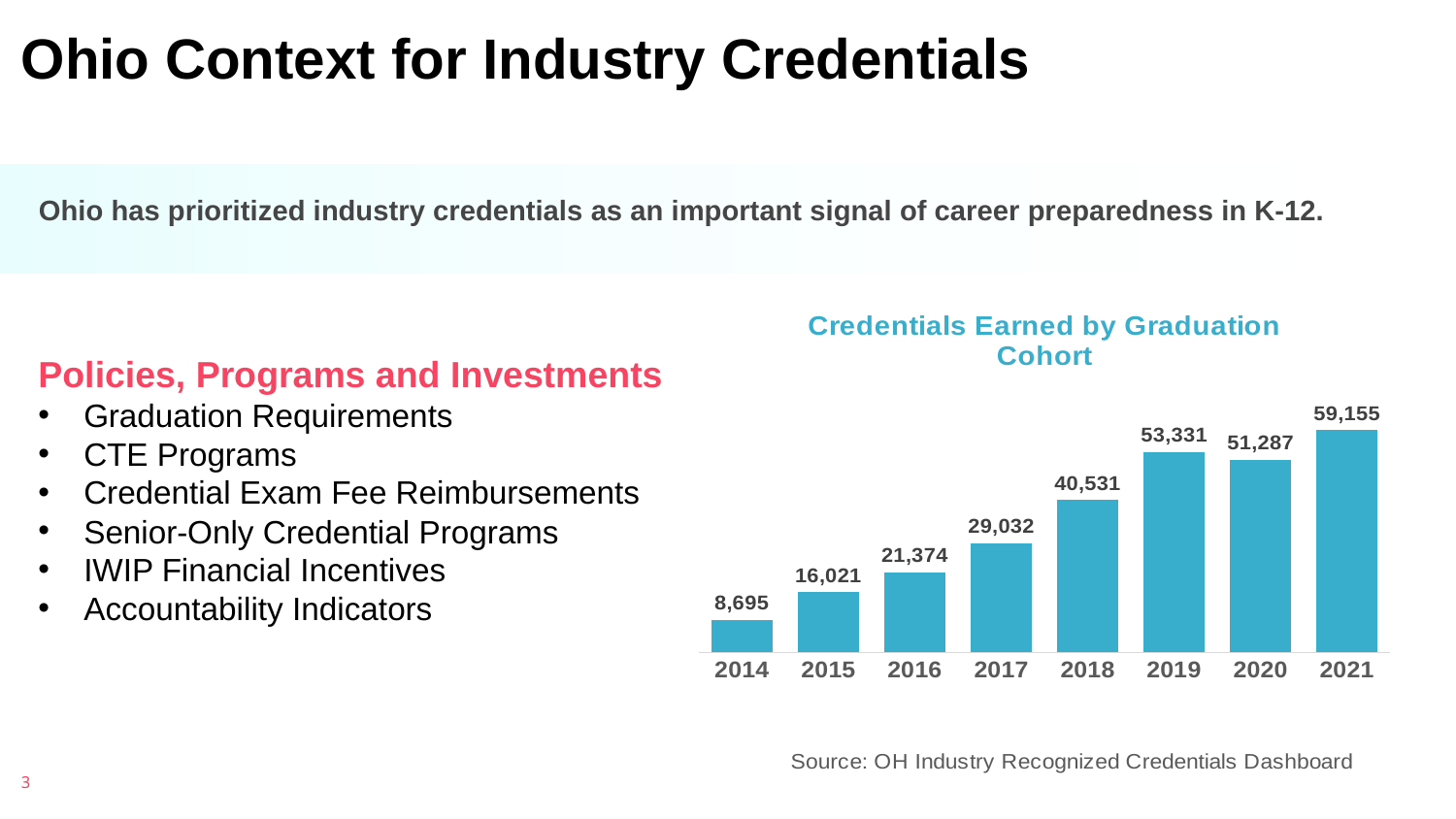
What is the difference between the 2021 and 2020 values? 7,868 What type of chart is used to show credentials earned by graduation cohort? Bar chart Which year has the highest number of credentials earned? 2021 How many graduation cohorts (years) are shown in the chart? 8 What is the value for 2014 in the Credentials Earned by Graduation Cohort chart? 8,695 Which is larger, the value for 2019 or the value for 2020? 2019 Which year has the lowest number of credentials earned? 2014 How much higher is the 2019 value than the 2020 value? 2,044 What is the value shown for 2020? 51,287 How many credentials were earned by the 2018 graduation cohort? 40,531 Do the values generally rise or fall from 2014 to 2021? Rise What is the title of the chart on the slide? Credentials Earned by Graduation Cohort